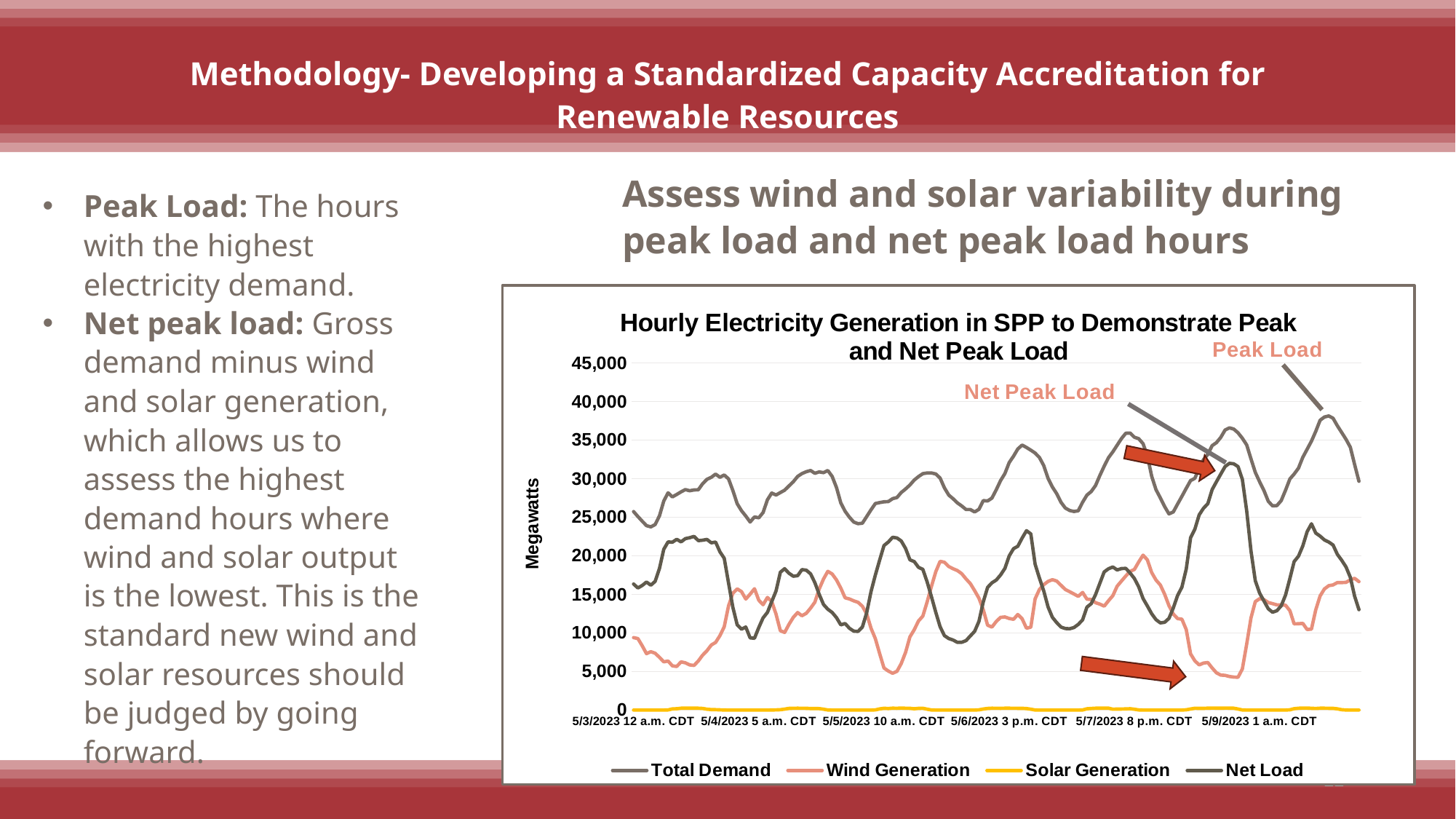
How many date/time labels are shown along the x-axis? 6 Is the Net Load value at the point labelled "Net Peak Load" greater or less than 25,000? greater What kind of chart is shown on the slide? Line chart What is the highest value shown on the y-axis? 45,000 Is the Wind Generation value at the point indicated by the lower red arrow greater or less than 10,000? less Is the Total Demand value at the point labelled "Peak Load" greater or less than 35,000? greater What is the title of the chart? Hourly Electricity Generation in SPP to Demonstrate Peak and Net Peak Load How many series does the chart legend list? 4 Which series reaches the highest value on the chart? Total Demand Which series stays lowest across the entire chart? Solar Generation What unit is shown on the chart's y-axis label? Megawatts